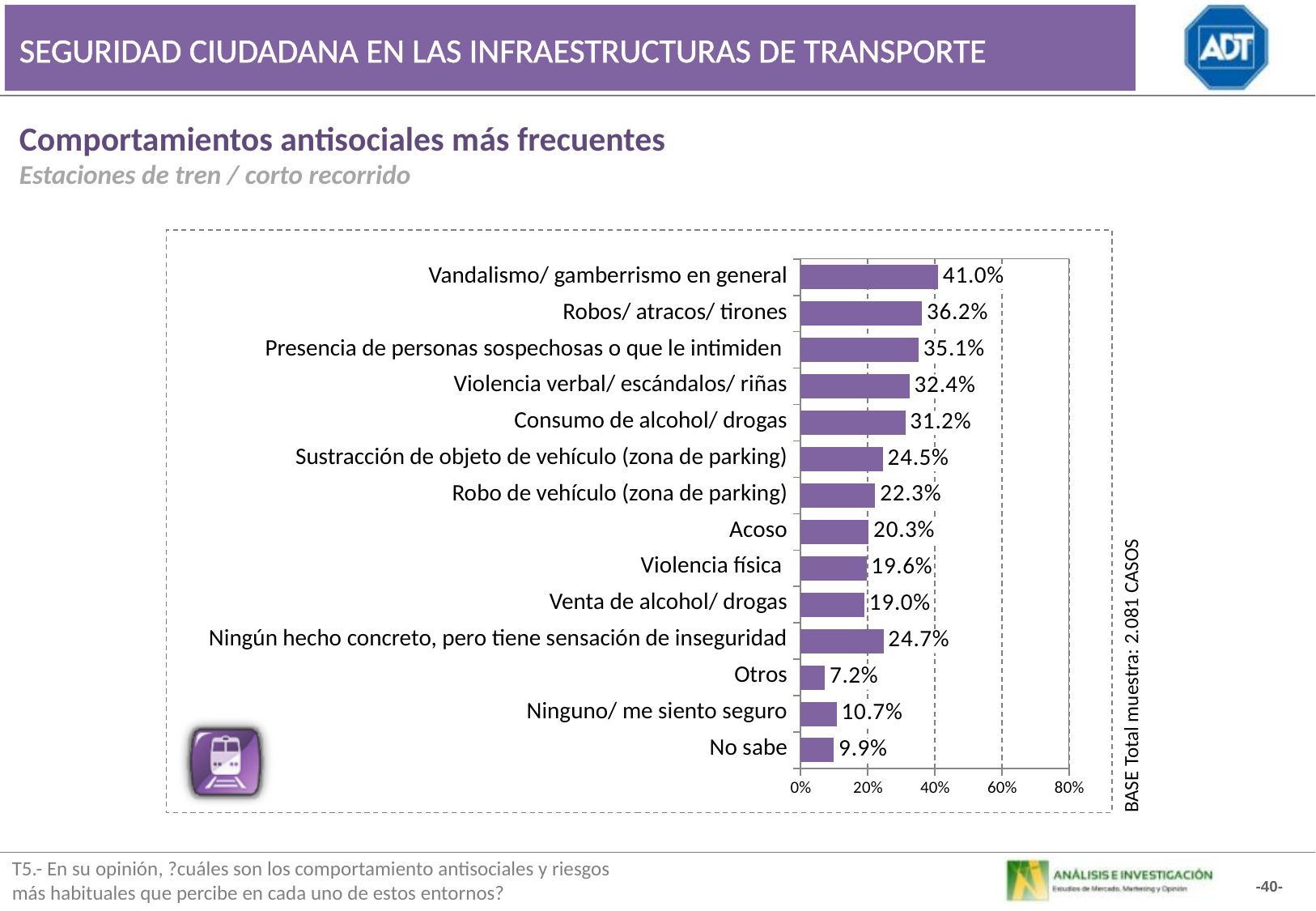
What is the value for Vandalismo/ gamberrismo en general? 41.0% How many categories are shown in the chart? 14 What is the value for Ninguno/ me siento seguro? 10.7% Is the value for Violencia verbal/ escándalos/ riñas greater or less than 40%? less What is the value for Ningún hecho concreto, pero tiene sensación de inseguridad? 24.7% Which category has the lowest value? Otros What is the difference between Robos/ atracos/ tirones and Consumo de alcohol/ drogas? 5.0% Which is larger, Acoso or Venta de alcohol/ drogas? Acoso What is the value for Robo de vehículo (zona de parking)? 22.3% What is the base sample size stated next to the chart? 2.081 CASOS What kind of chart is shown on the slide? bar chart Which category has the highest value? Vandalismo/ gamberrismo en general